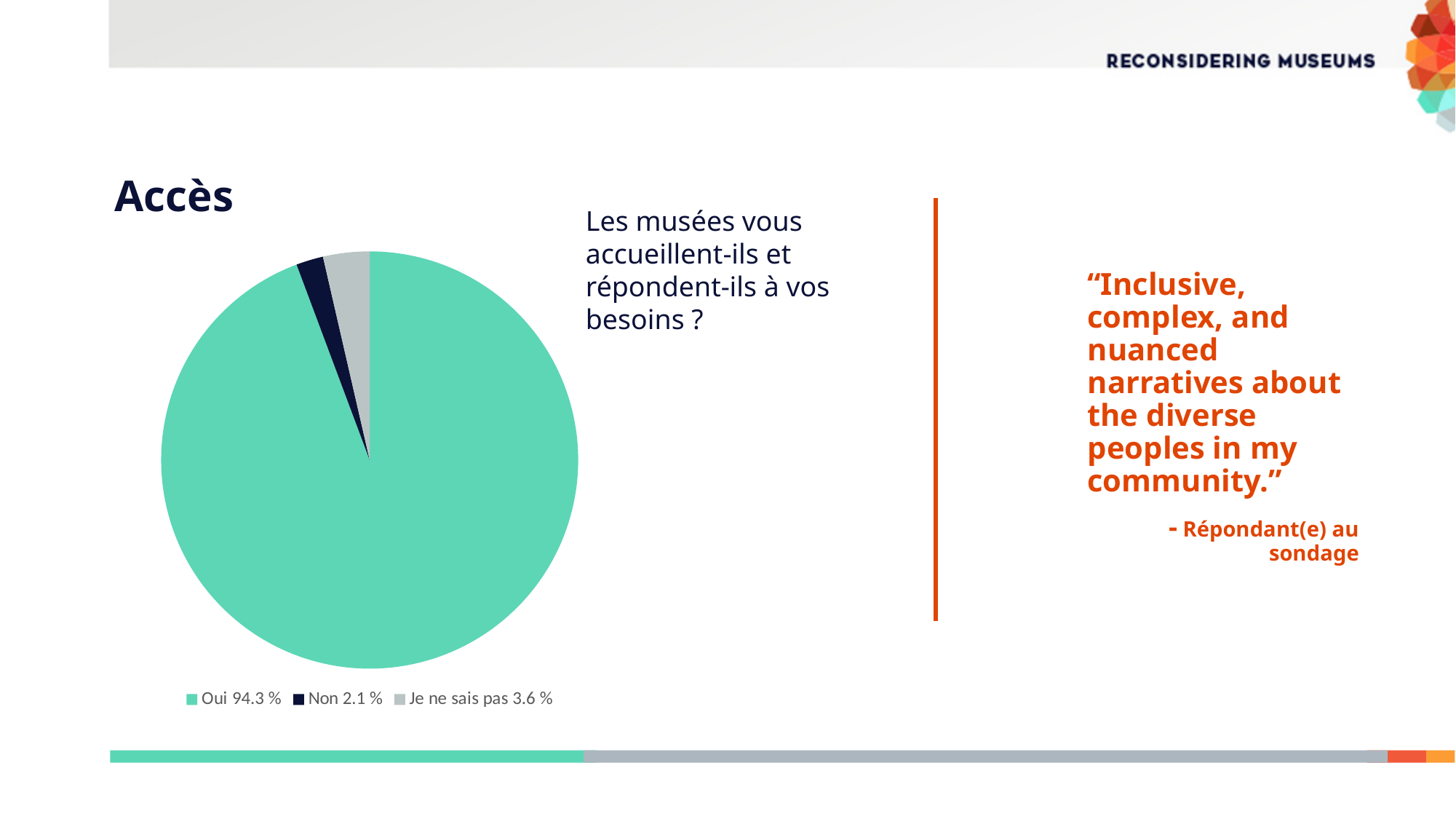
What is the difference between the "Je ne sais pas" share and the "Non" share? 1.5 % What question does the pie chart answer, according to the text next to it? Les musées vous accueillent-ils et répondent-ils à vos besoins ? Which response has the smallest slice of the pie? Non Which is larger, the share for "Non" or the share for "Je ne sais pas"? Je ne sais pas What colour is the "Oui" slice of the pie chart? green What share of respondents answered "Non"? 2.1 % How many categories does the pie chart have? 3 What share of respondents answered "Oui"? 94.3 % What kind of chart is shown on the slide? pie chart Which response has the largest slice of the pie? Oui What is the difference between the "Oui" share and the "Je ne sais pas" share? 90.7 % What share of respondents answered "Je ne sais pas"? 3.6 %